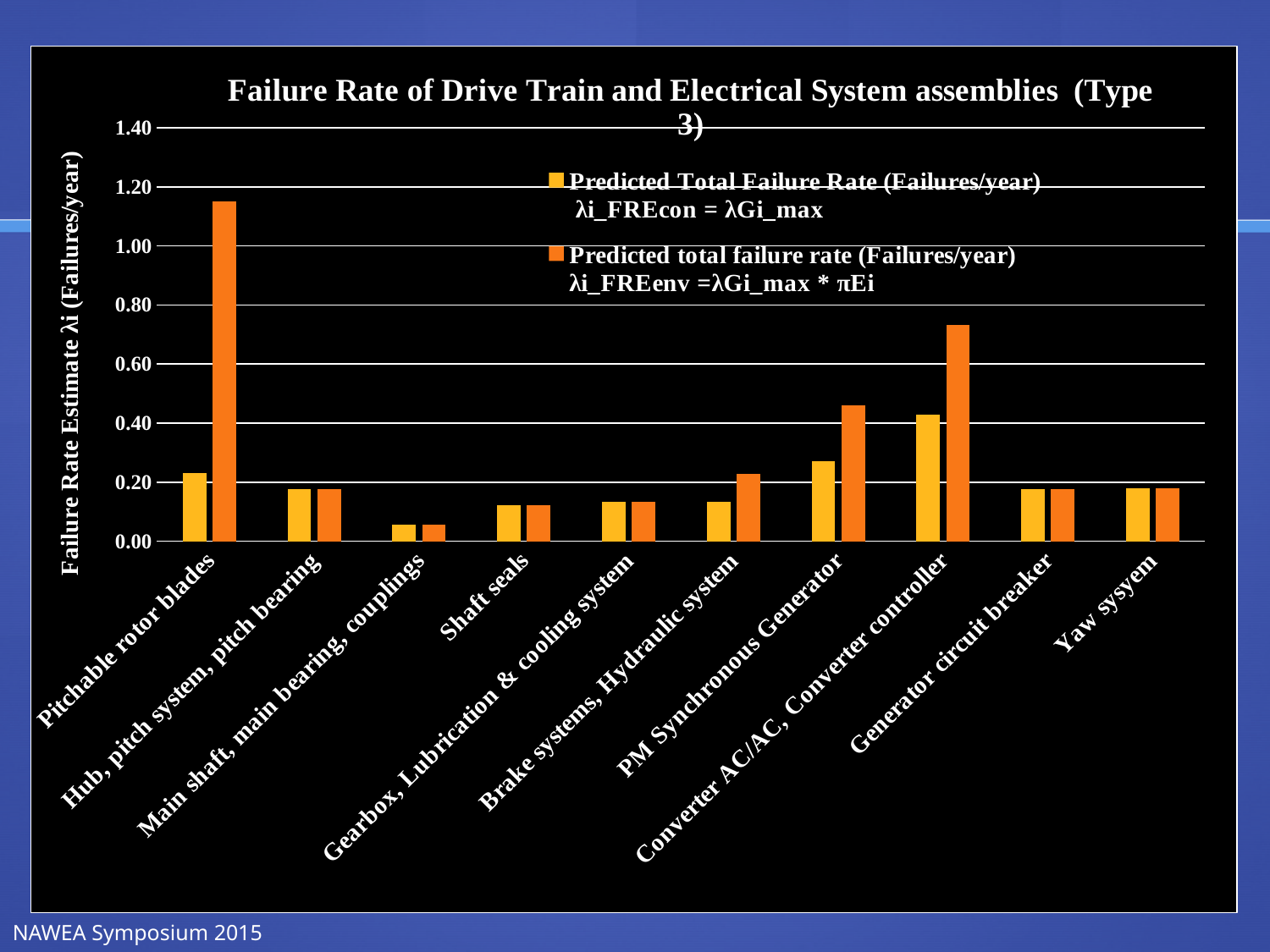
Which has the larger yellow λi_FREcon value: PM Synchronous Generator or Converter AC/AC, Converter controller? Converter AC/AC, Converter controller Is the yellow λi_FREcon value for Main shaft, main bearing, couplings greater or less than 0.20? less What kind of chart is shown on the slide? bar chart Is the orange λi_FREenv value for Converter AC/AC, Converter controller greater or less than 0.60? greater Which category has the highest Predicted Total Failure Rate λi_FREcon (yellow bars)? Converter AC/AC, Converter controller How many series does the chart's legend list? 2 What is the label of the chart's vertical axis? Failure Rate Estimate λi (Failures/year) Which category has the lowest Predicted total failure rate λi_FREenv (orange bars)? Main shaft, main bearing, couplings Is the orange λi_FREenv value for Pitchable rotor blades greater or less than 1.00? greater Which category has the highest Predicted total failure rate λi_FREenv (orange bars)? Pitchable rotor blades How many assembly categories are shown on the x axis of the chart? 10